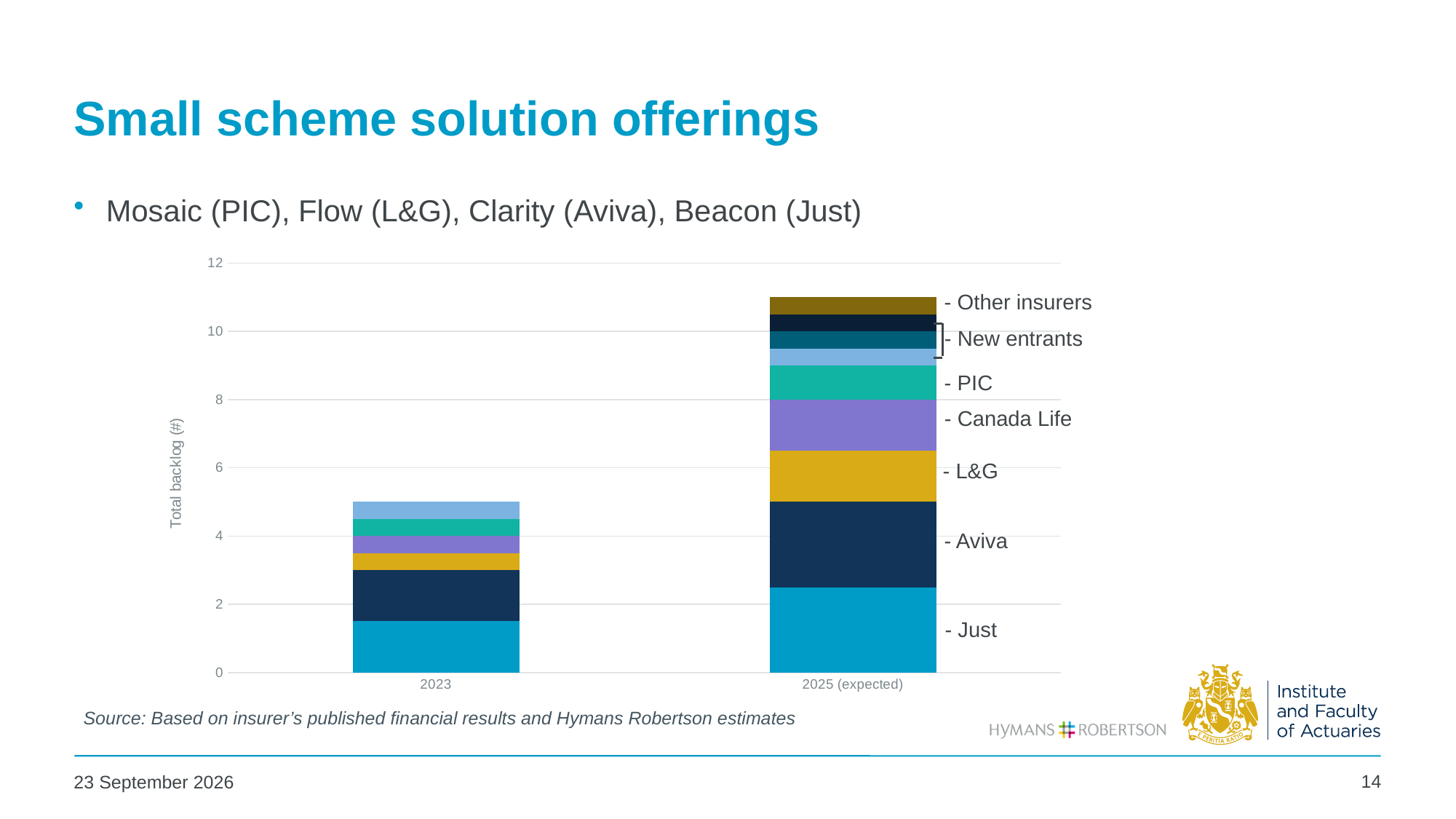
Which category on the x axis is marked as expected? 2025 (expected) Is the total backlog for 2025 (expected) greater or less than 12? less How many insurer groups are labelled beside the 2025 (expected) bar? 7 Which bar is taller, 2023 or 2025 (expected)? 2025 (expected) Is the total backlog for 2025 (expected) greater or less than 10? greater Does the total backlog rise or fall from 2023 to 2025 (expected)? Rise How many categories are shown on the x axis of the chart? 2 Is the total backlog for 2023 greater or less than 6? less What kind of chart is shown on the slide? Stacked bar chart What is the label on the y axis of the chart? Total backlog (#) Which insurer's segment is at the bottom of the stacked bars? Just